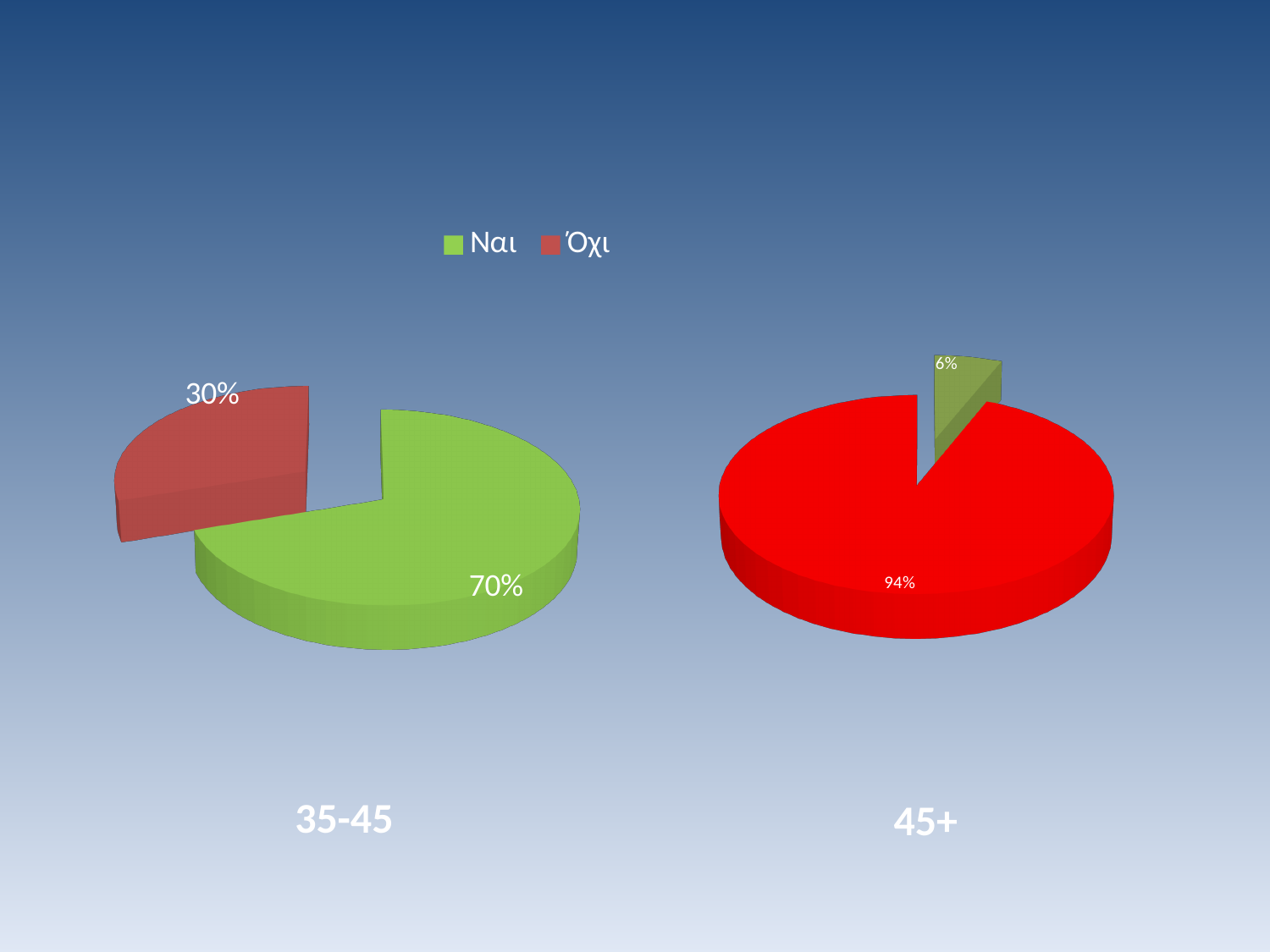
What kind of chart is used on the left side of the slide, labelled 35-45? Pie chart In the 35-45 pie chart, what percentage is shown for Ναι? 70% How many slices does the 45+ pie chart have? 2 Is the Ναι share larger in the 35-45 chart or in the 45+ chart? 35-45 In the 45+ pie chart, what percentage is shown for Ναι? 6% In the 35-45 pie chart, what is the difference between the Ναι and Όχι shares? 40% In the 45+ pie chart, what is the difference between the Όχι and Ναι shares? 88% In the 45+ pie chart, what percentage is shown for Όχι? 94% In the 45+ pie chart, which category has the smallest share? Ναι In the 35-45 pie chart, which category has the largest share? Ναι In the 35-45 pie chart, what percentage is shown for Όχι? 30% How many entries does the legend at the top of the slide list? 2